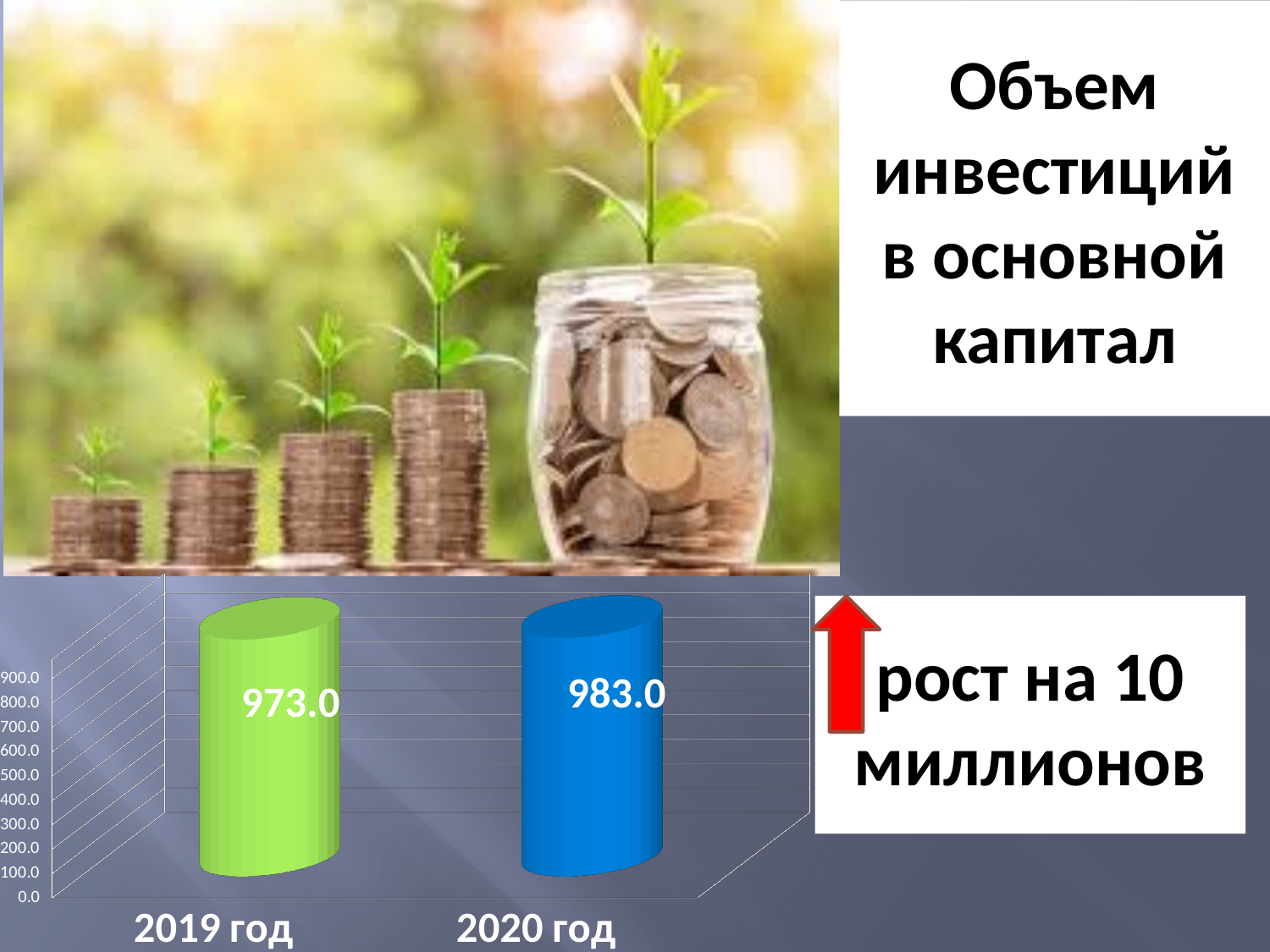
What is the value shown for 2019 год? 973.0 How many categories are plotted on the chart? 2 What colour is the bar for 2019 год? green What is the value shown for 2020 год? 983.0 Is the value for 2020 год larger or smaller than the value for 2019 год? larger What colour is the bar for 2020 год? blue Which year has the lower value on the chart? 2019 год What is the difference between the values for 2020 год and 2019 год? 10.0 Which year has the higher value on the chart? 2020 год What kind of chart is shown on the slide? bar chart Is the value for 2019 год greater or less than 900? greater Do the values rise or fall from 2019 год to 2020 год? rise